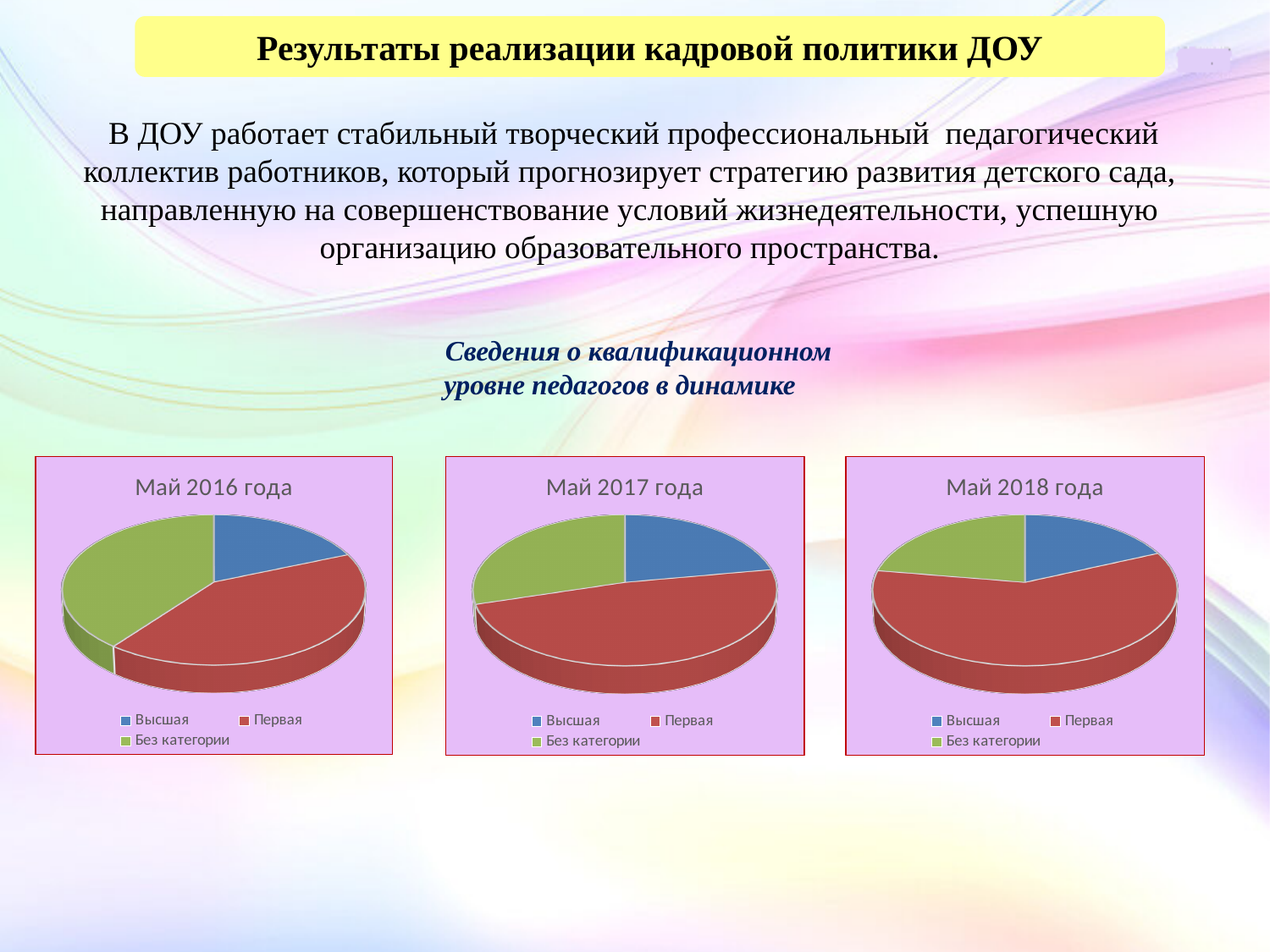
In the "Май 2018 года" chart, which slice is larger: Без категории or Первая? Первая How many entries does the legend of the "Май 2018 года" chart list? 3 In the "Май 2018 года" chart, which category has the largest slice? Первая In the "Май 2018 года" chart, what colour represents the category Первая? red In the "Май 2016 года" chart, which slice is larger: Без категории or Высшая? Без категории What kind of chart is the "Май 2016 года" chart? pie chart In the "Май 2017 года" chart, which category has the largest slice? Первая In the "Май 2016 года" chart, which category has the largest slice? Первая In the "Май 2017 года" chart, which slice is larger: Первая or Высшая? Первая How many slices does the "Май 2017 года" pie chart have? 3 What is the title of the leftmost pie chart on the slide? Май 2016 года In the "Май 2016 года" chart, which category has the smallest slice? Высшая